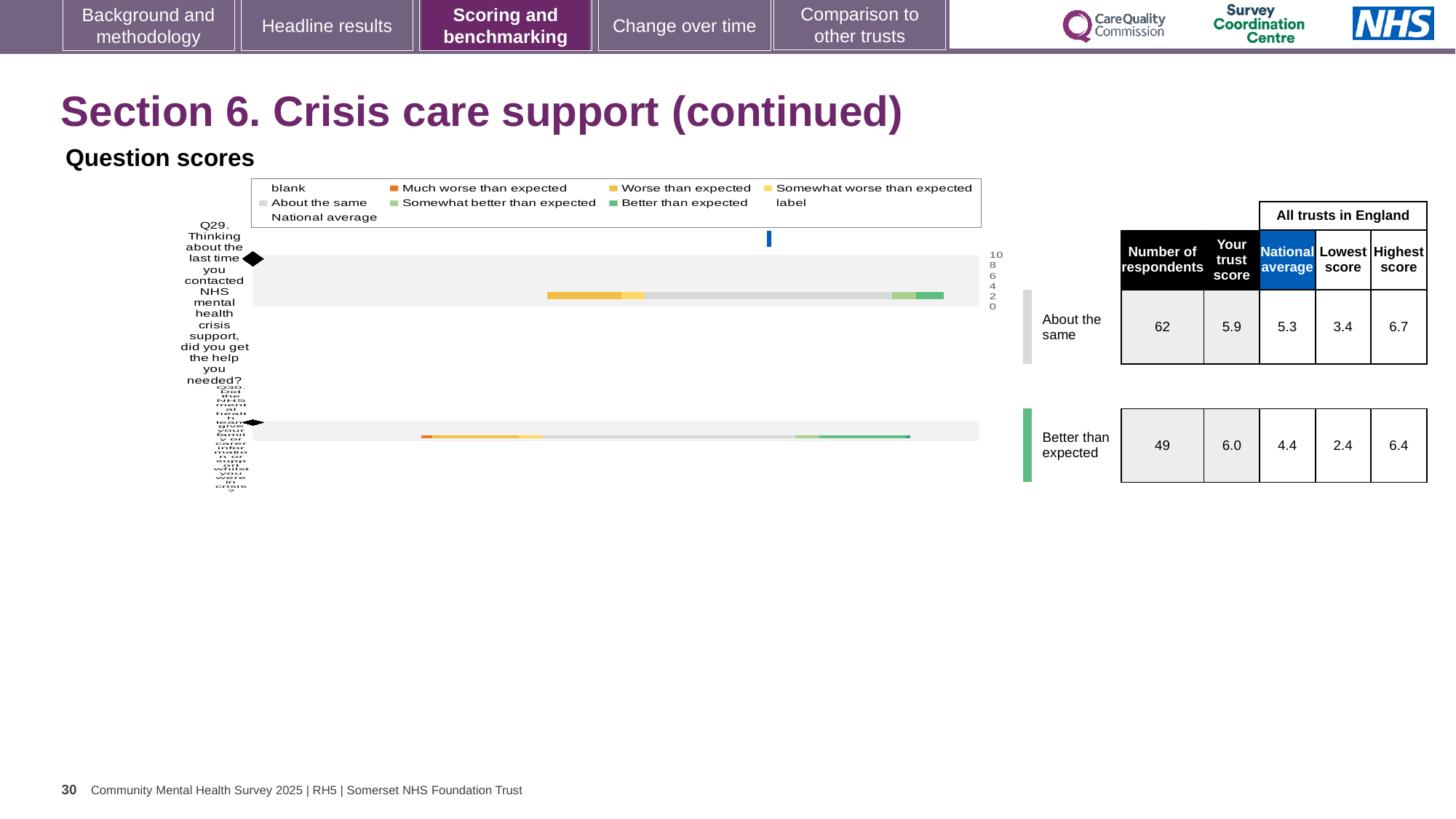
What is the national average for Q29 (did you get the help you needed?)? 5.3 What is the trust score for the question rated 'Better than expected'? 6.0 What is the difference between the trust score and the national average for the question rated 'Better than expected'? 1.6 Which benchmark category is shown for Q29 (Thinking about the last time you contacted NHS mental health crisis support, did you get the help you needed?)? About the same What kind of chart is used to show the question scores on this slide? bar chart Which benchmark category is shown for the second (lower) question bar in the chart? Better than expected How many questions are plotted in the question scores chart? 2 How many respondents answered Q29 (did you get the help you needed?)? 62 For Q29 (did you get the help you needed?), which is larger: the trust score or the national average? trust score What is the difference between the highest score for Q29 (6.7) and the highest score for the 'Better than expected' question (6.4)? 0.3 What is the lowest score across all trusts in England for the question rated 'Better than expected'? 2.4 What is the trust score for Q29 (did you get the help you needed?)? 5.9